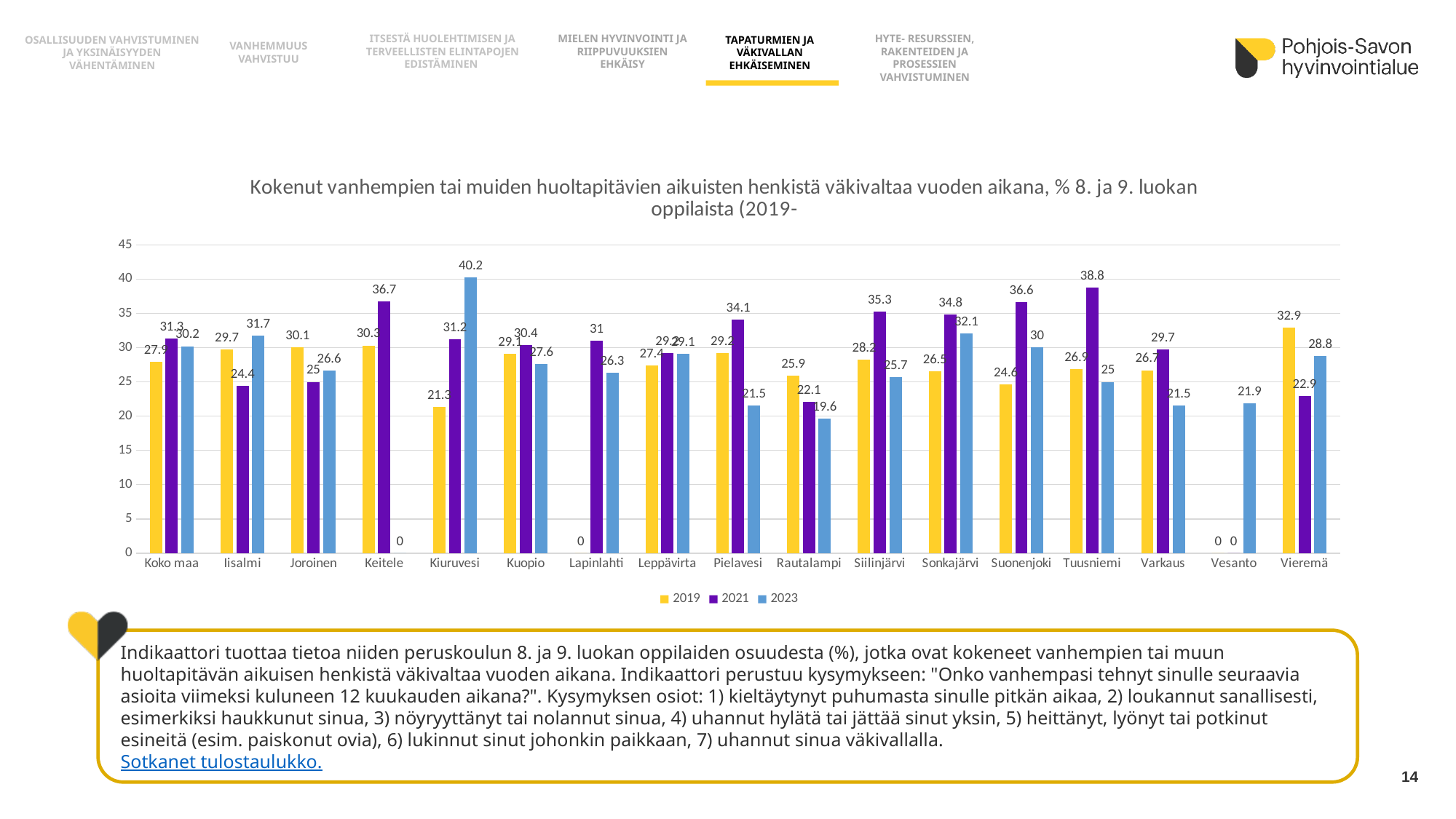
Which is larger for Pielavesi, the 2021 value or the 2023 value? 2021 How many series does the legend list? 3 Which category has the highest 2021 value? Tuusniemi How many categories are shown on the x axis? 17 What is the 2023 value for Kiuruvesi? 40.2 What is the difference between the 2023 and 2019 values for Kiuruvesi? 18.9 Which category has the highest 2023 value? Kiuruvesi What is the 2023 value for Vesanto? 21.9 What kind of chart is shown on the slide? Bar chart What is the 2019 value for Koko maa? 27.9 What is the 2021 value for Tuusniemi? 38.8 Which category has the highest 2019 value? Vieremä